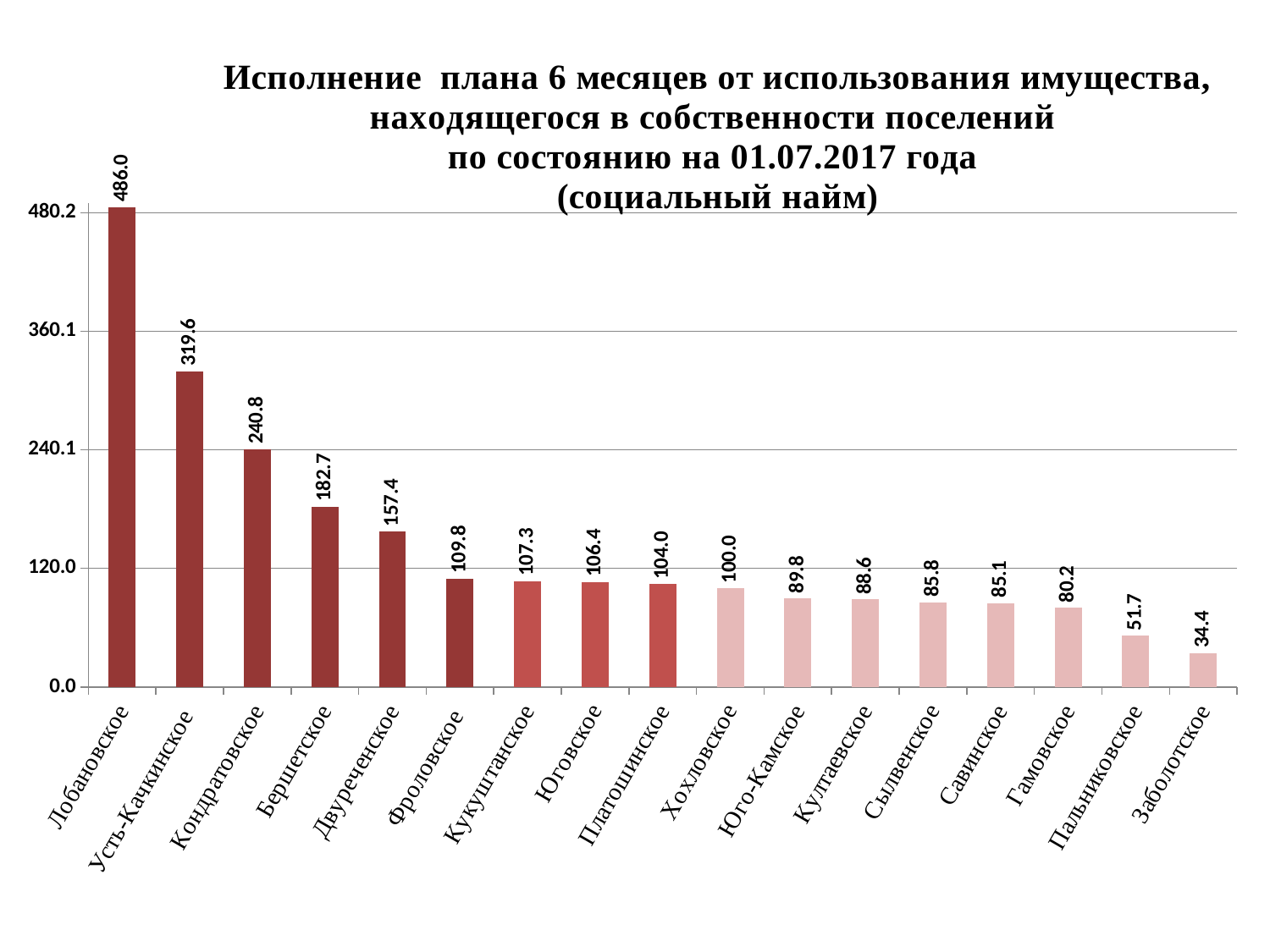
What is the value for Гамовское? 80.2 What is the value for Лобановское? 486.0 Is the value for Фроловское greater or less than 120.0? less What is the difference between the values for Усть-Качкинское and Кондратовское? 78.8 What kind of chart is shown on the slide? bar chart Do the values rise or fall from left to right along the x axis? fall How many categories are shown on the x axis? 17 Which category has the lowest value? Заболотское What is the difference between the values for Пальниковское and Заболотское? 17.3 What is the value for Кондратовское? 240.8 Which category has the highest value? Лобановское Which is larger, the value for Бершетское or the value for Двуреченское? Бершетское